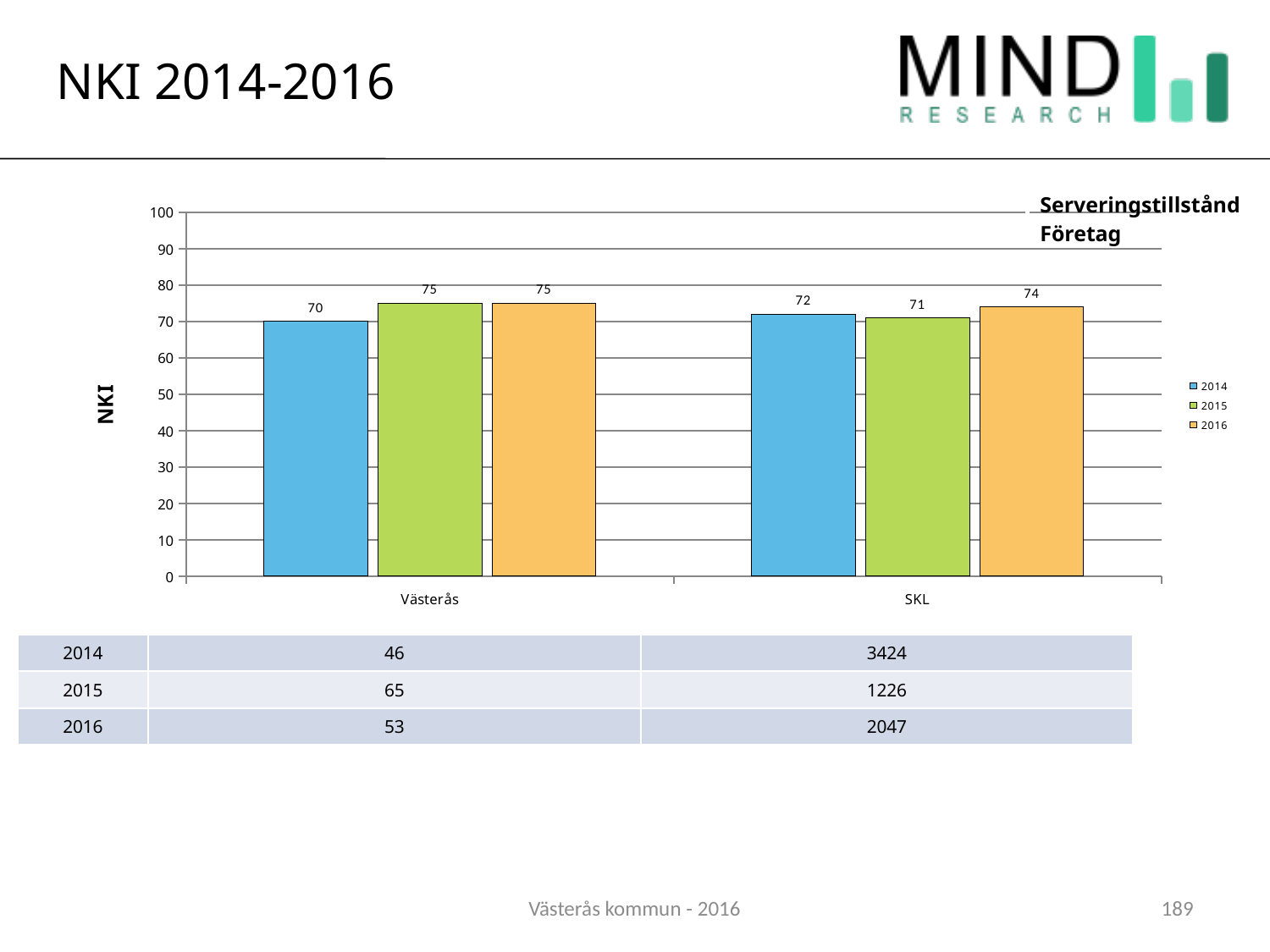
What is the difference between the 2016 NKI values for Västerås and SKL? 1 What is the difference between the 2015 and 2014 NKI values for Västerås? 5 Which year has the lowest NKI value for Västerås? 2014 Which is larger, the 2014 NKI value for Västerås or for SKL? SKL What is the NKI value for Västerås in 2014? 70 How many series does the chart legend list? 3 What is the NKI value for SKL in 2016? 74 Is the 2015 NKI value for SKL greater or less than 60? greater How many categories are shown on the x axis of the chart? 2 What is the NKI value for SKL in 2015? 71 What kind of chart is shown on the slide? bar chart Which year has the highest NKI value for SKL? 2016